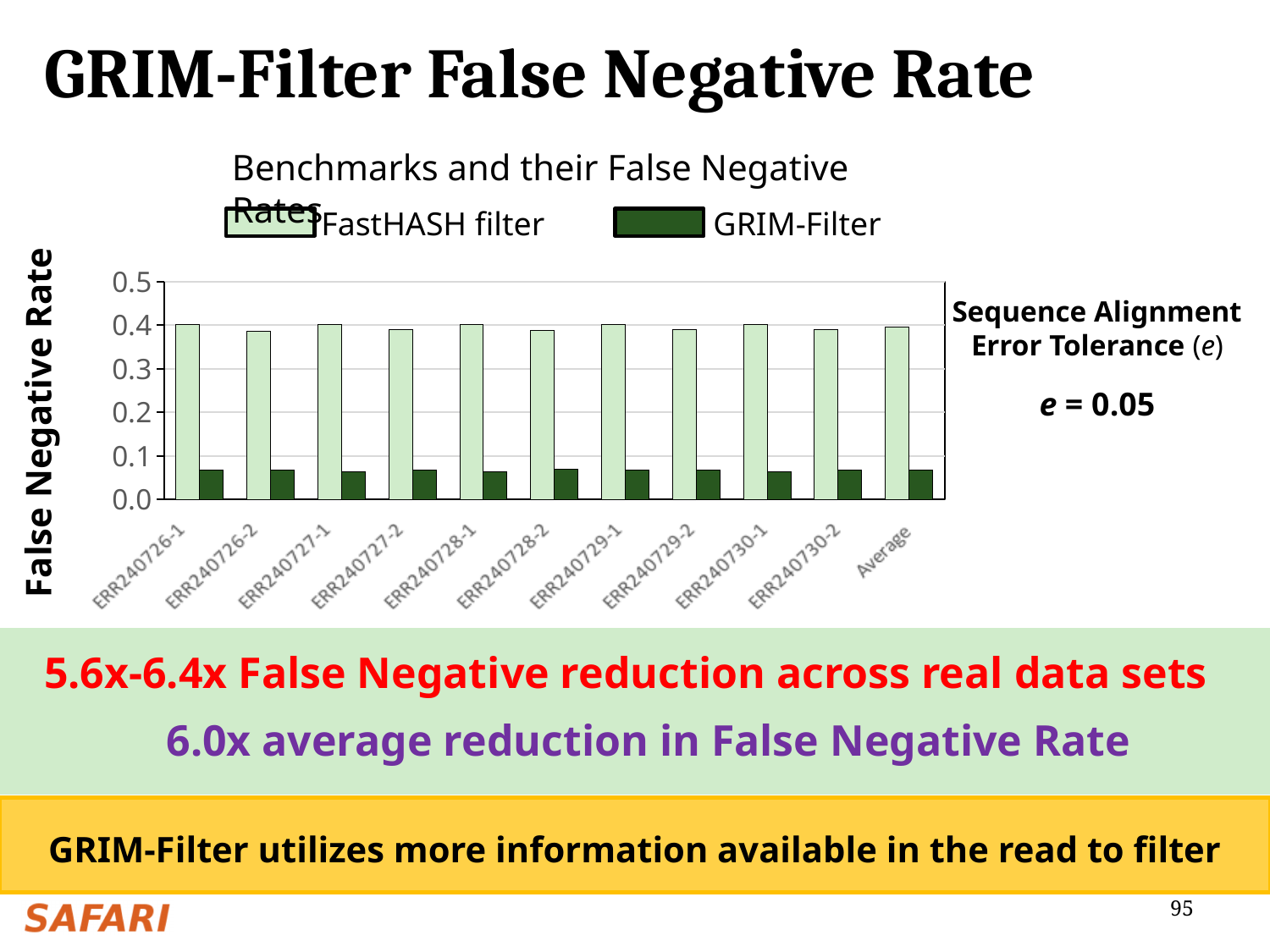
Is the GRIM-Filter value for ERR240726-1 greater or less than 0.1? less How many categories are shown along the x axis of the chart? 11 Is the GRIM-Filter value for Average greater or less than 0.2? less Is the FastHASH filter value for Average greater or less than 0.3? greater For the Average category, which series has the larger value, FastHASH filter or GRIM-Filter? FastHASH filter Which series is shown in dark green in the chart legend? GRIM-Filter What is the label of the y axis of the chart? False Negative Rate What kind of chart is shown on the slide? bar chart How many series does the chart legend list? 2 For ERR240728-1, which series has the smaller value, FastHASH filter or GRIM-Filter? GRIM-Filter